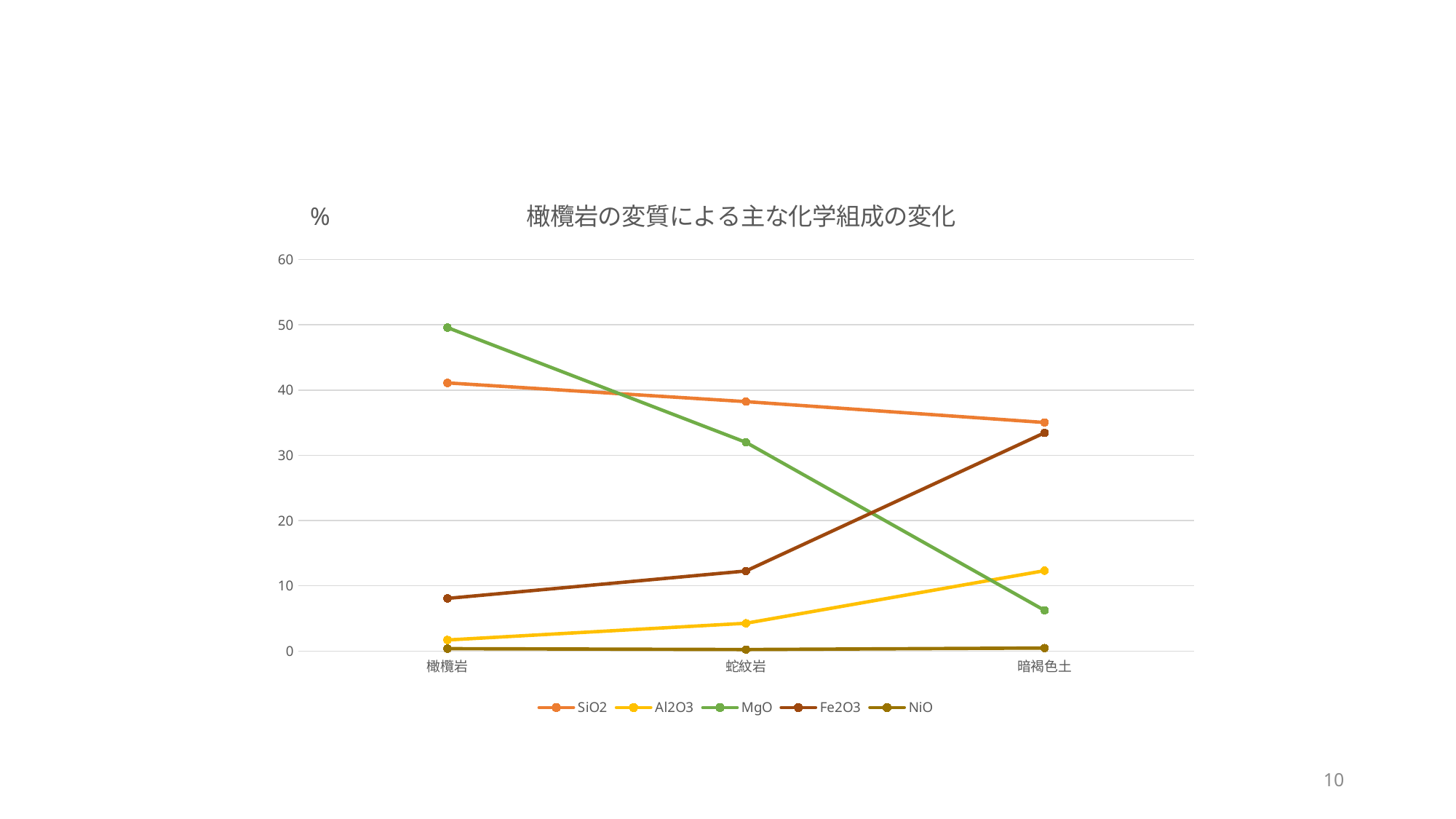
Which series has the lowest value at 橄欖岩? NiO Does the Fe2O3 series rise or fall from 橄欖岩 to 暗褐色土? rise Is the value for Fe2O3 at 橄欖岩 greater or less than 10? less What unit is shown at the top of the y axis? % Does the MgO series rise or fall from 橄欖岩 to 暗褐色土? fall What kind of chart is shown on the slide? line chart What is the title of the chart? 橄欖岩の変質による主な化学組成の変化 Which series has the highest value at 橄欖岩? MgO At 蛇紋岩, which is larger, SiO2 or MgO? SiO2 How many categories are shown on the x axis? 3 How many series does the legend list? 5 Is the value for MgO at 橄欖岩 greater or less than 40? greater